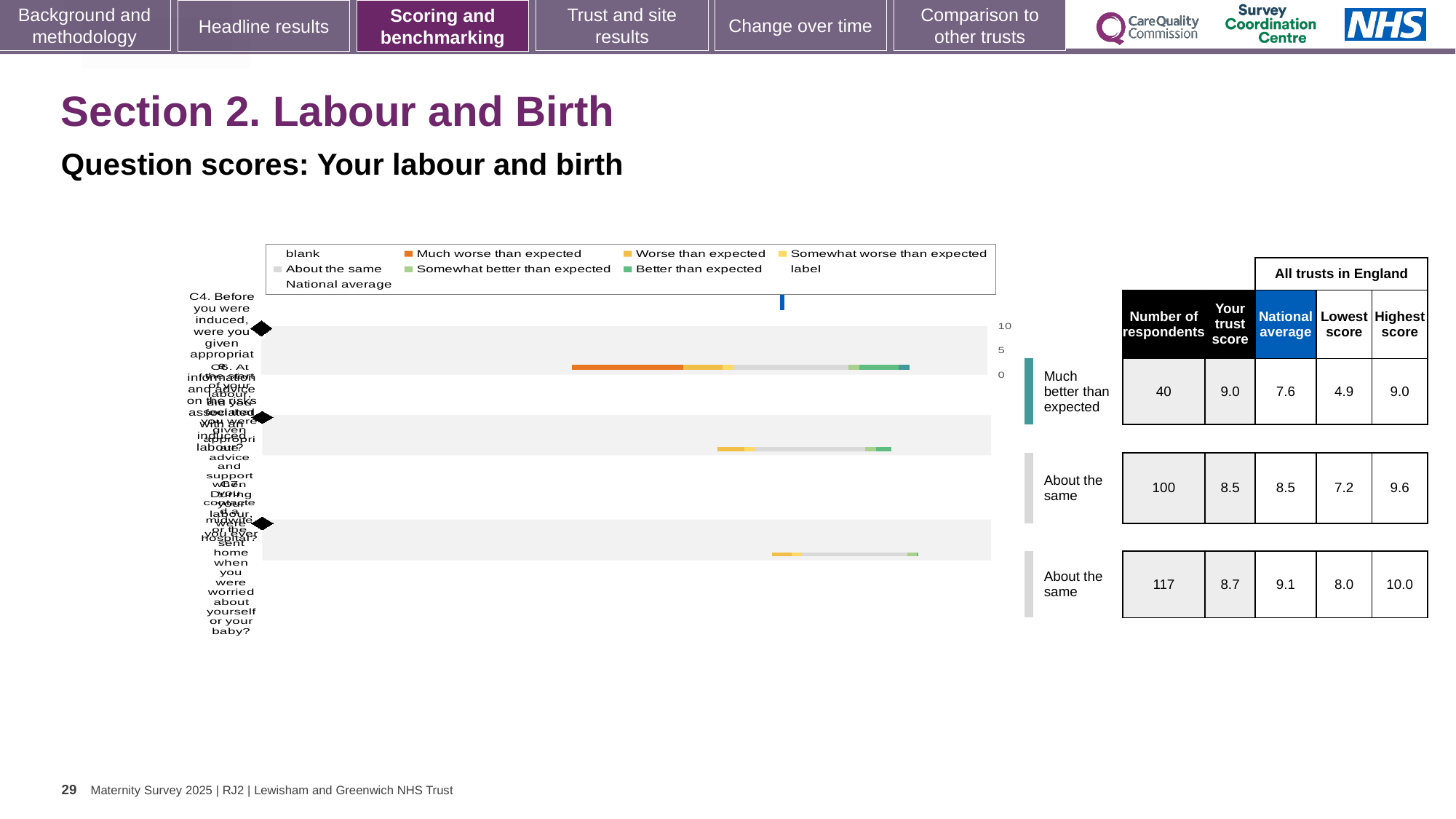
What is the subtitle above the chart? Question scores: Your labour and birth In the table beside the chart, what is the trust score for the row labelled 'Much better than expected'? 9.0 In the table beside the chart, which row has the highest number of respondents? the third row (117) In the table beside the chart, for the third row, which is larger: the trust score or the national average? national average What kind of chart is shown on the slide? bar chart In the table beside the chart, what is the difference between the highest score and the lowest score in the first row? 4.1 In the chart legend, what colour represents 'Much worse than expected'? orange How many question rows (bars) are plotted in the chart? 3 In the table beside the chart, what is the lowest score for the second row? 7.2 In the table beside the chart, what is the national average for the first row? 7.6 In the table beside the chart, what is the number of respondents for the first row (labelled 'Much better than expected')? 40 In the table beside the chart, what is the highest score for the third row? 10.0